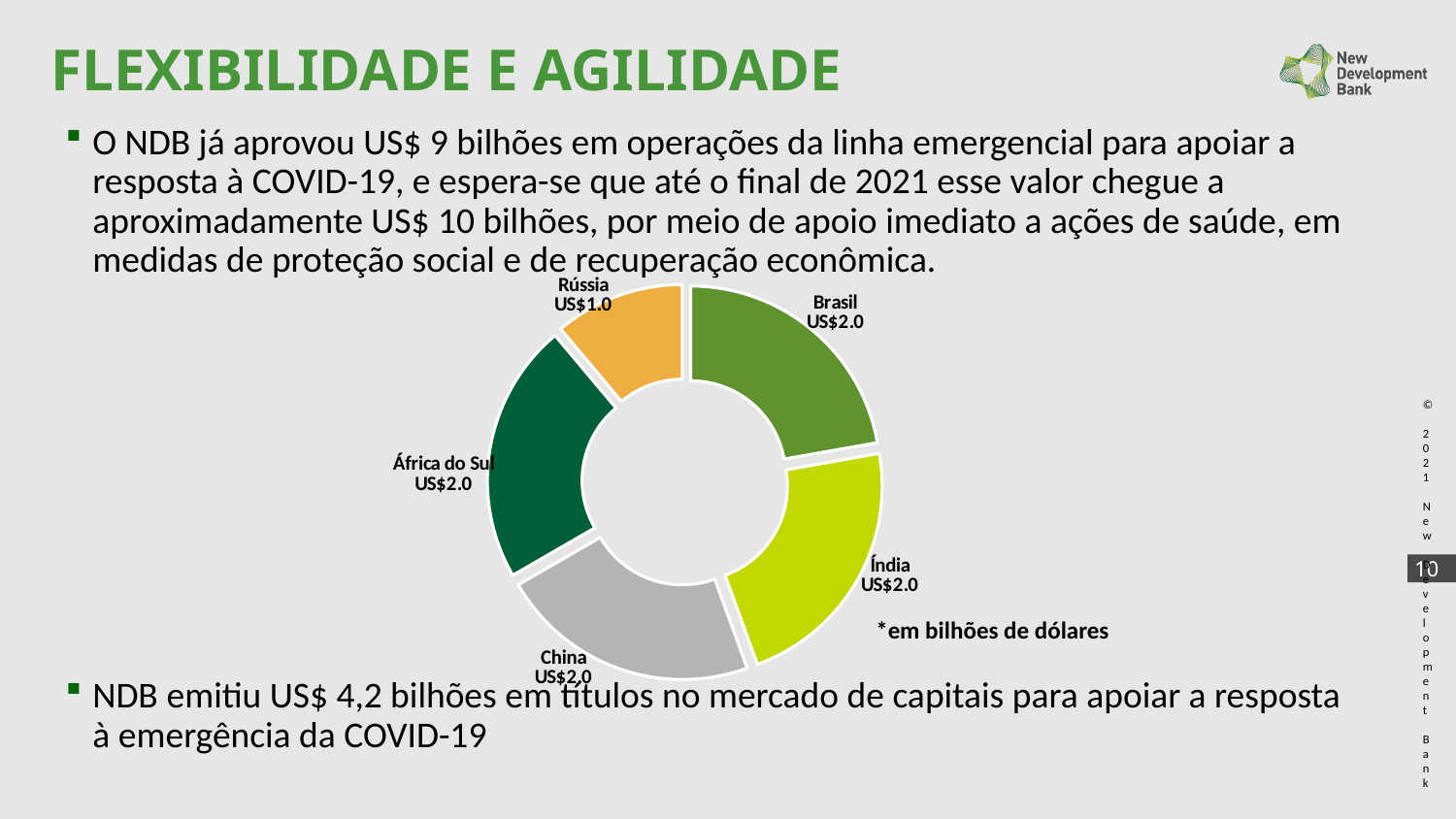
What is the value shown for Rússia in the doughnut chart? US$1.0 What is the value shown for Índia in the doughnut chart? US$2.0 What is the value shown for África do Sul in the doughnut chart? US$2.0 According to the note next to the doughnut chart, in what unit are the values expressed? em bilhões de dólares What is the difference between the values for China and Rússia in the doughnut chart? US$1.0 What is the value shown for China in the doughnut chart? US$2.0 Which is larger in the doughnut chart, the value for Brasil or the value for Rússia? Brasil How many countries are shown in the doughnut chart? 5 What kind of chart is shown on the slide? Doughnut (pie) chart What is the value shown for Brasil in the doughnut chart? US$2.0 What is the total of all the values shown in the doughnut chart? US$9.0 Which country has the lowest value in the doughnut chart? Rússia